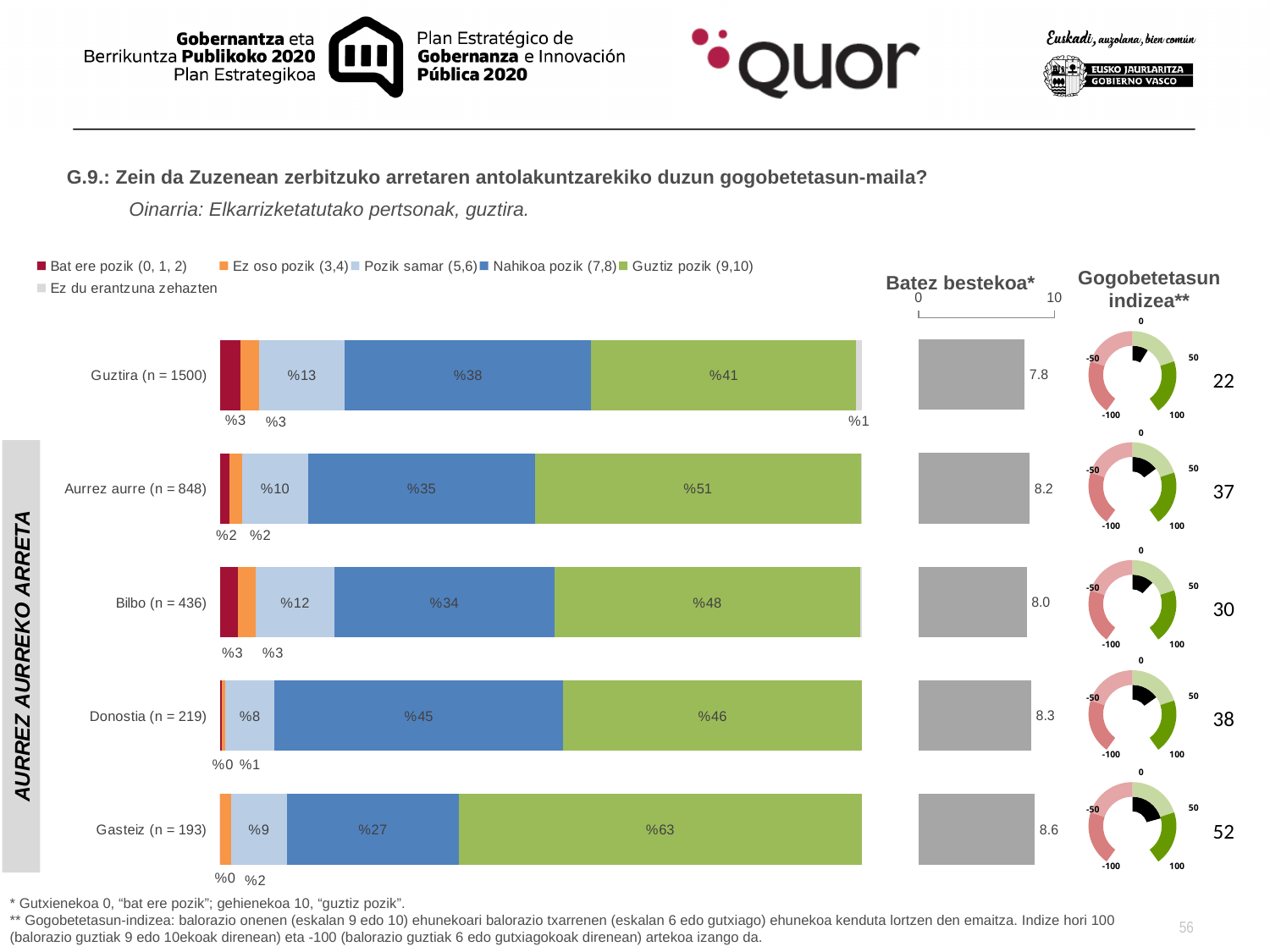
In the "Gogobetetasun indizea**" gauges, what is the value for Aurrez aurre (n = 848)? 37 In the stacked bar chart, what is the value of "Nahikoa pozik (7,8)" for Donostia (n = 219)? %45 In the stacked bar chart, what is the value of "Guztiz pozik (9,10)" for Gasteiz (n = 193)? %63 In the "Batez bestekoa*" chart, what is the value for Gasteiz (n = 193)? 8.6 In the stacked bar chart, which is larger: the "Nahikoa pozik (7,8)" value for Donostia (n = 219) or for Gasteiz (n = 193)? Donostia (n = 219) In the stacked bar chart, which category has the highest value for "Guztiz pozik (9,10)"? Gasteiz (n = 193) In the stacked bar chart, which category has the lowest value for "Guztiz pozik (9,10)"? Guztira (n = 1500) In the stacked bar chart, what is the difference between the "Guztiz pozik (9,10)" values for Gasteiz (n = 193) and Bilbo (n = 436)? %15 In the stacked bar chart, what is the value of "Pozik samar (5,6)" for Guztira (n = 1500)? %13 In the "Batez bestekoa*" chart, which category has the lowest value? Guztira (n = 1500) How many categories are shown in the stacked bar chart? 5 How many series does the legend of the stacked bar chart list? 6